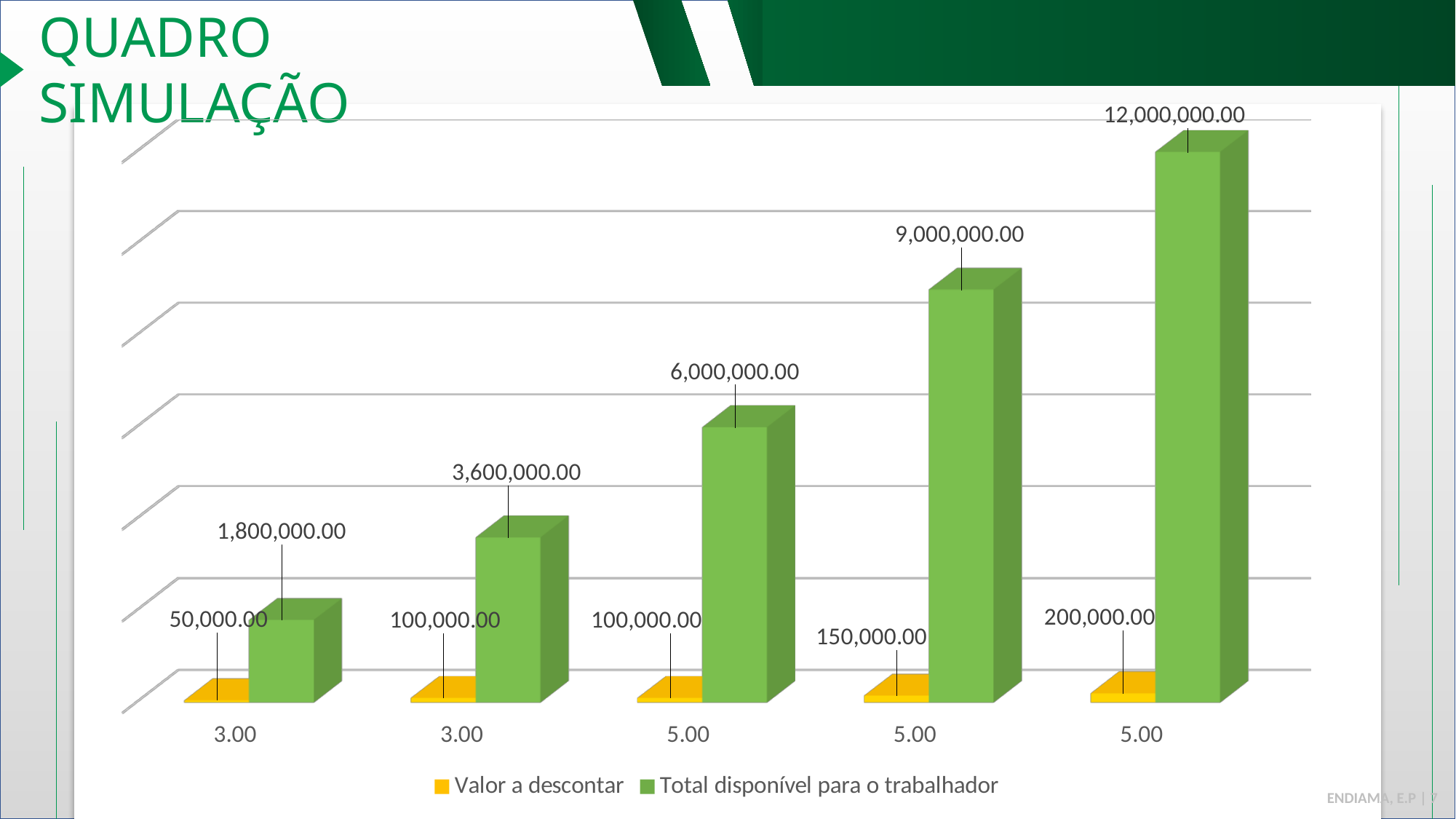
Which colour represents "Valor a descontar" in the legend? Yellow What is the difference between the "Total disponível para o trabalhador" values of the rightmost and the fourth categories? 3,000,000.00 What is the value of "Valor a descontar" for the rightmost category? 200,000.00 What is the value of "Valor a descontar" for the fourth category from the left? 150,000.00 What is the value of "Total disponível para o trabalhador" for the first (leftmost) category? 1,800,000.00 Do the "Total disponível para o trabalhador" values rise or fall from left to right? Rise Which category has the highest "Total disponível para o trabalhador" value? The rightmost category (12,000,000.00) How many series does the legend list? 2 What is the value of "Total disponível para o trabalhador" for the middle (third) category? 6,000,000.00 What is the lowest "Valor a descontar" value shown? 50,000.00 What kind of chart is shown on the slide? Bar chart How many categories are plotted along the x axis? 5